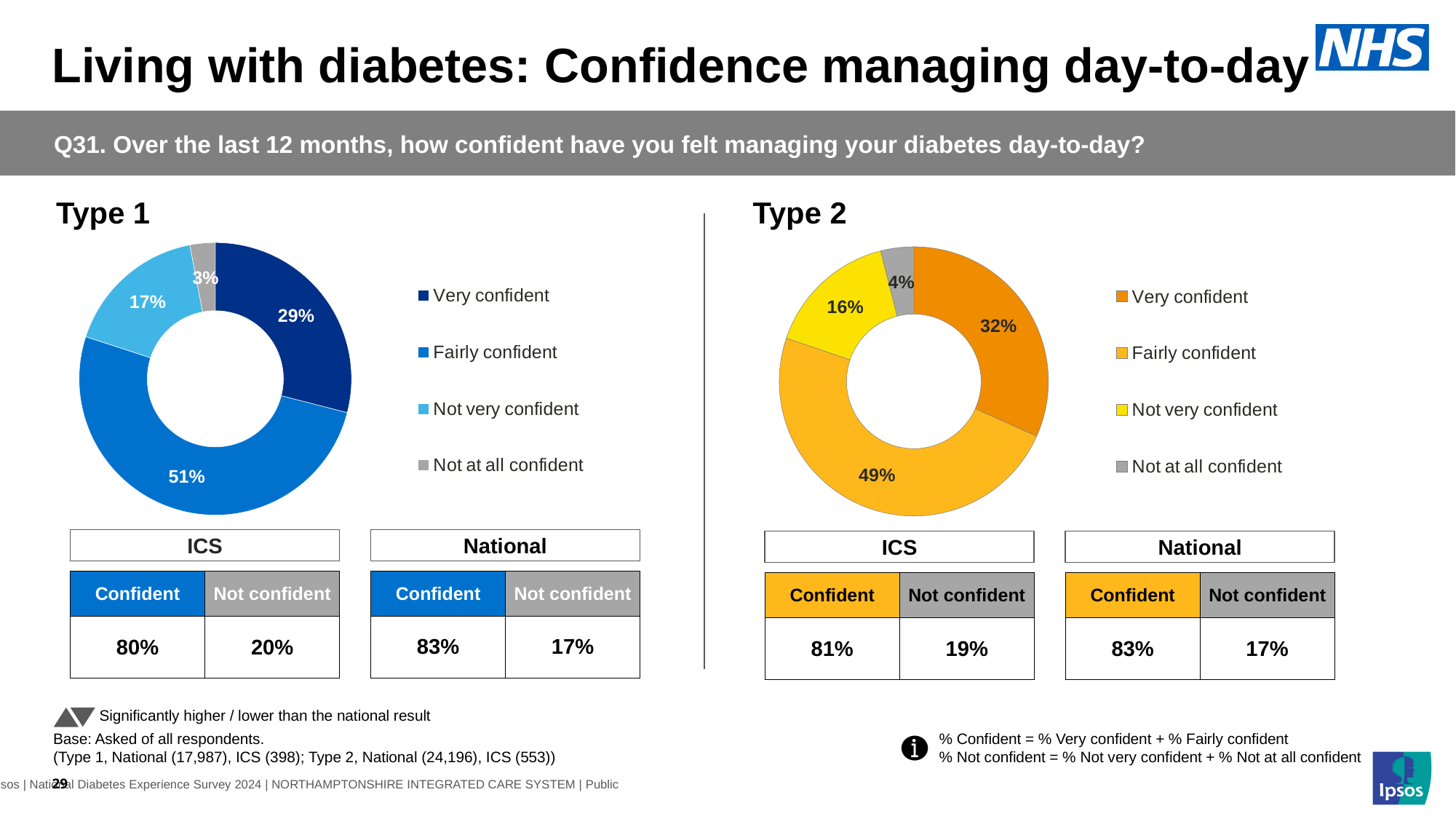
In the Type 1 chart, what percentage of respondents were Not at all confident? 3% How many categories does the Type 1 chart show? 4 In the Type 2 chart, what percentage of respondents were Fairly confident? 49% In the Type 1 chart, what is the difference between the Fairly confident and Very confident shares? 22% In the Type 2 chart, what is the difference between the Very confident and Not very confident shares? 16% In the Type 1 chart, which category has the largest share? Fairly confident What kind of chart is used for Type 2? Doughnut chart In the Type 1 chart, what colour represents Not very confident? Light blue In the Type 2 chart, which category has the smallest share? Not at all confident Which is larger: the Very confident share in the Type 1 chart or the Very confident share in the Type 2 chart? Type 2 In the Type 1 chart, what percentage of respondents were Very confident? 29% In the Type 2 chart, what percentage of respondents were Not very confident? 16%